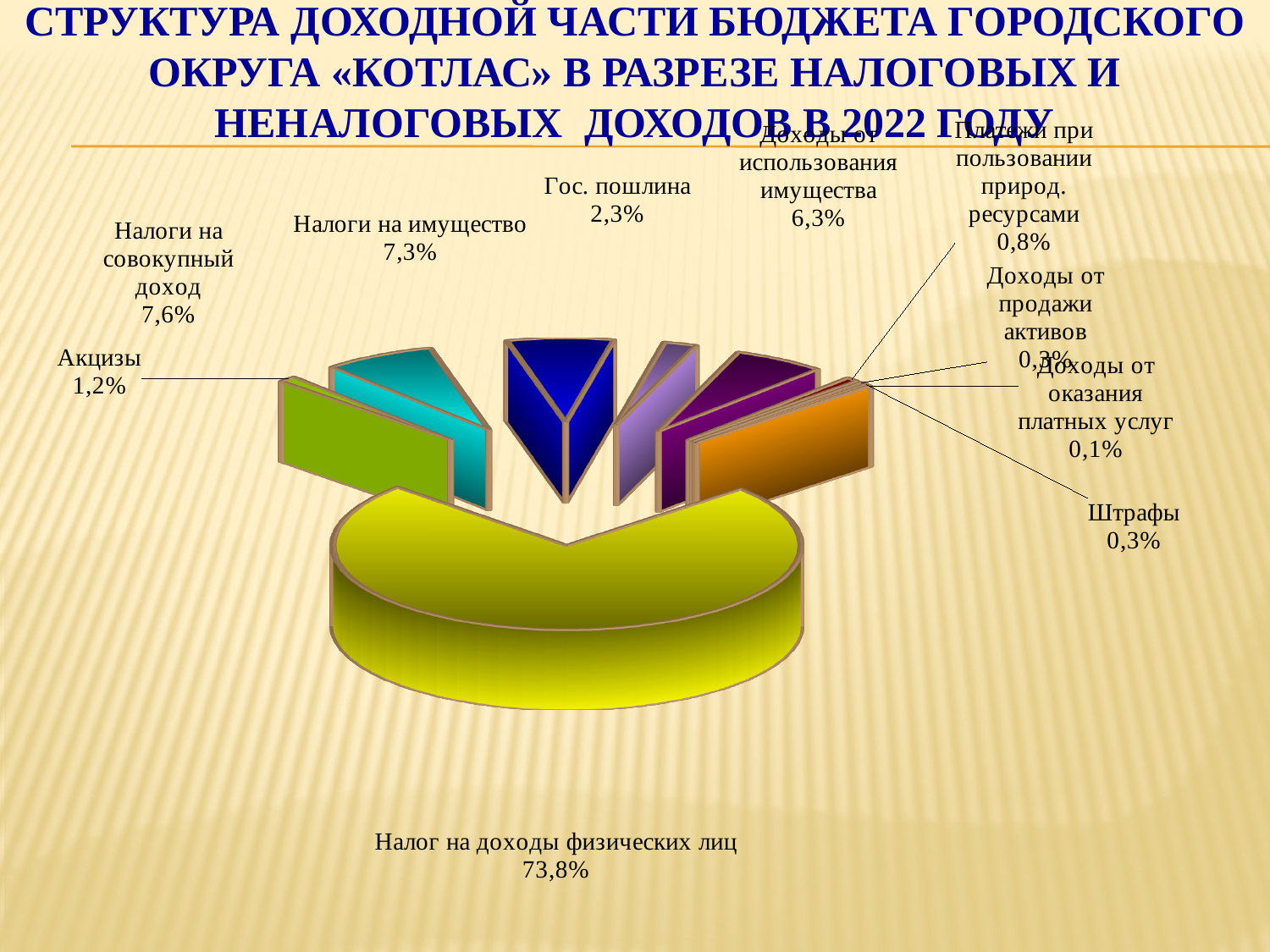
Which category has the smallest share of the pie? Доходы от оказания платных услуг Which is larger: the share of Доходы от использования имущества or the share of Гос. пошлина? Доходы от использования имущества What is the value shown for Налоги на имущество? 7,3% What kind of chart is shown on the slide? pie chart Which category has the largest share of the pie? Налог на доходы физических лиц What is the value shown for Доходы от использования имущества? 6,3% What is the value shown for Штрафы? 0,3% What share of the budget revenue is Налог на доходы физических лиц? 73,8% How many categories are shown in the pie chart? 10 What is the value shown for Гос. пошлина? 2,3% What is the value shown for Акцизы? 1,2% What is the difference between the shares of Налоги на совокупный доход and Налоги на имущество? 0,3%